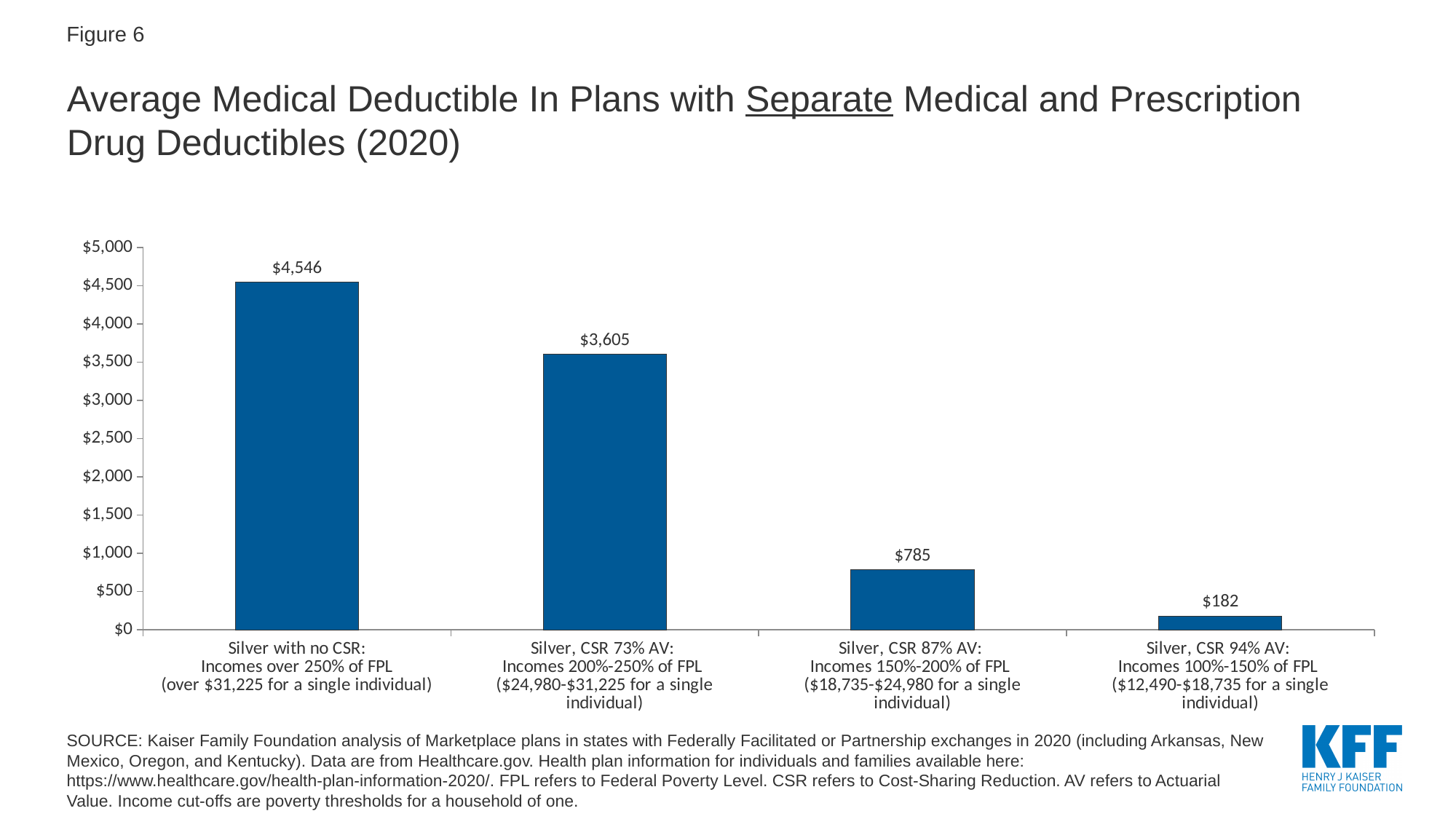
What is the average medical deductible for Silver plans with no CSR? $4,546 What is the average medical deductible for Silver, CSR 87% AV plans? $785 Which plan category has the highest average medical deductible? Silver with no CSR What type of chart is shown on the slide? Bar chart Which plan category has the lowest average medical deductible? Silver, CSR 94% AV What is the difference between the average medical deductible for Silver with no CSR and Silver, CSR 73% AV? $941 Do the average medical deductibles rise or fall moving from left to right across the categories? Fall How many plan categories are shown in the chart? 4 What is the average medical deductible for Silver, CSR 94% AV plans? $182 What is the difference between the average medical deductible for Silver, CSR 87% AV and Silver, CSR 94% AV? $603 Which has a larger average medical deductible: Silver, CSR 73% AV or Silver, CSR 87% AV? Silver, CSR 73% AV What is the average medical deductible for Silver, CSR 73% AV plans? $3,605